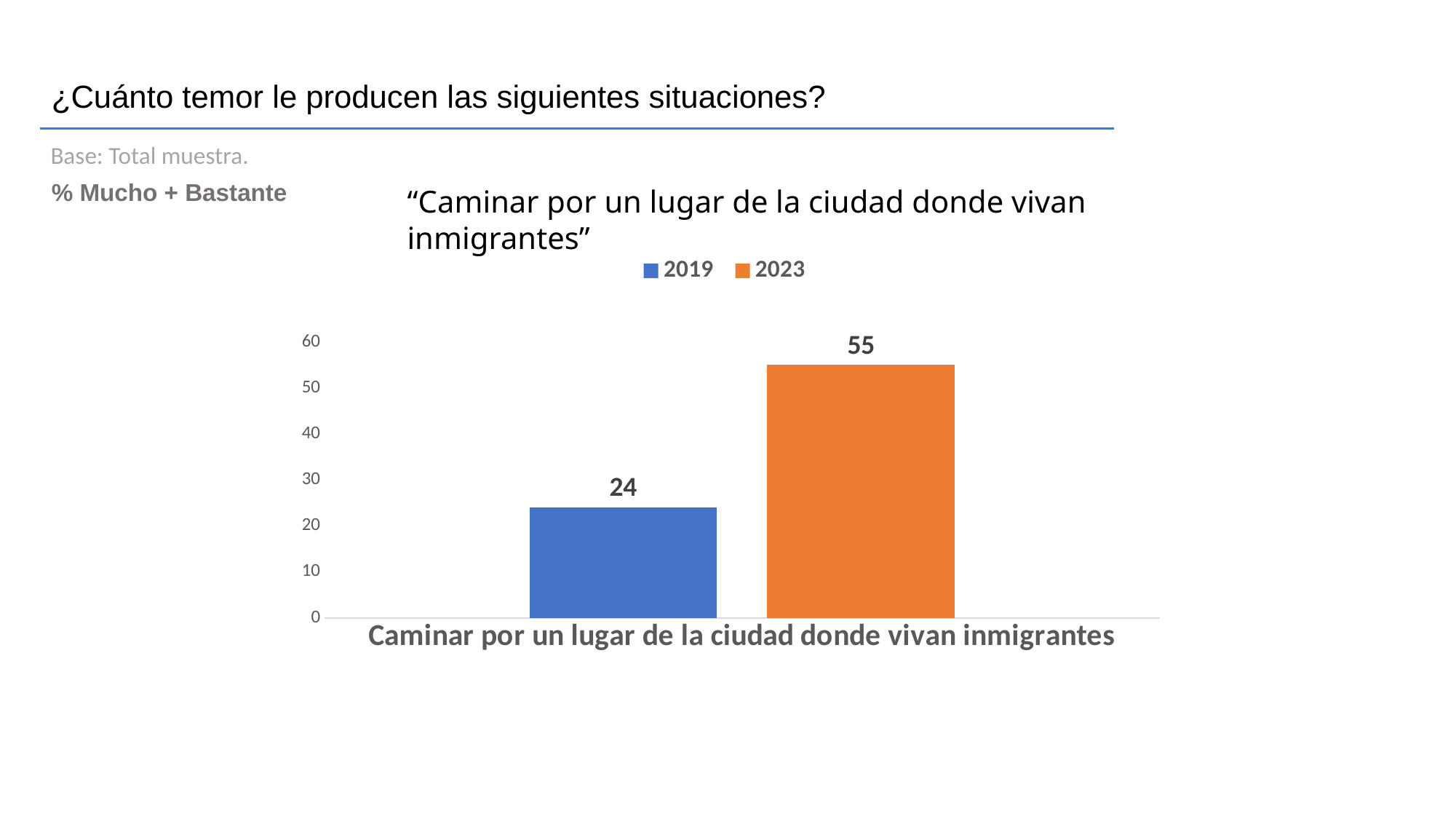
How many series does the legend list? 2 What is the value for 2019 in the chart? 24 Which year has the higher value, 2019 or 2023? 2023 Is the value for 2023 greater or less than 50? greater Is the value for 2019 greater or less than 30? less What colour is the bar for 2023? Orange Which series has the highest value in the chart? 2023 Did the value rise or fall from 2019 to 2023? Rise Which series has the lowest value in the chart? 2019 What kind of chart is shown on the slide? Bar chart What is the value for 2023 in the chart? 55 What is the difference between the 2023 value and the 2019 value? 31